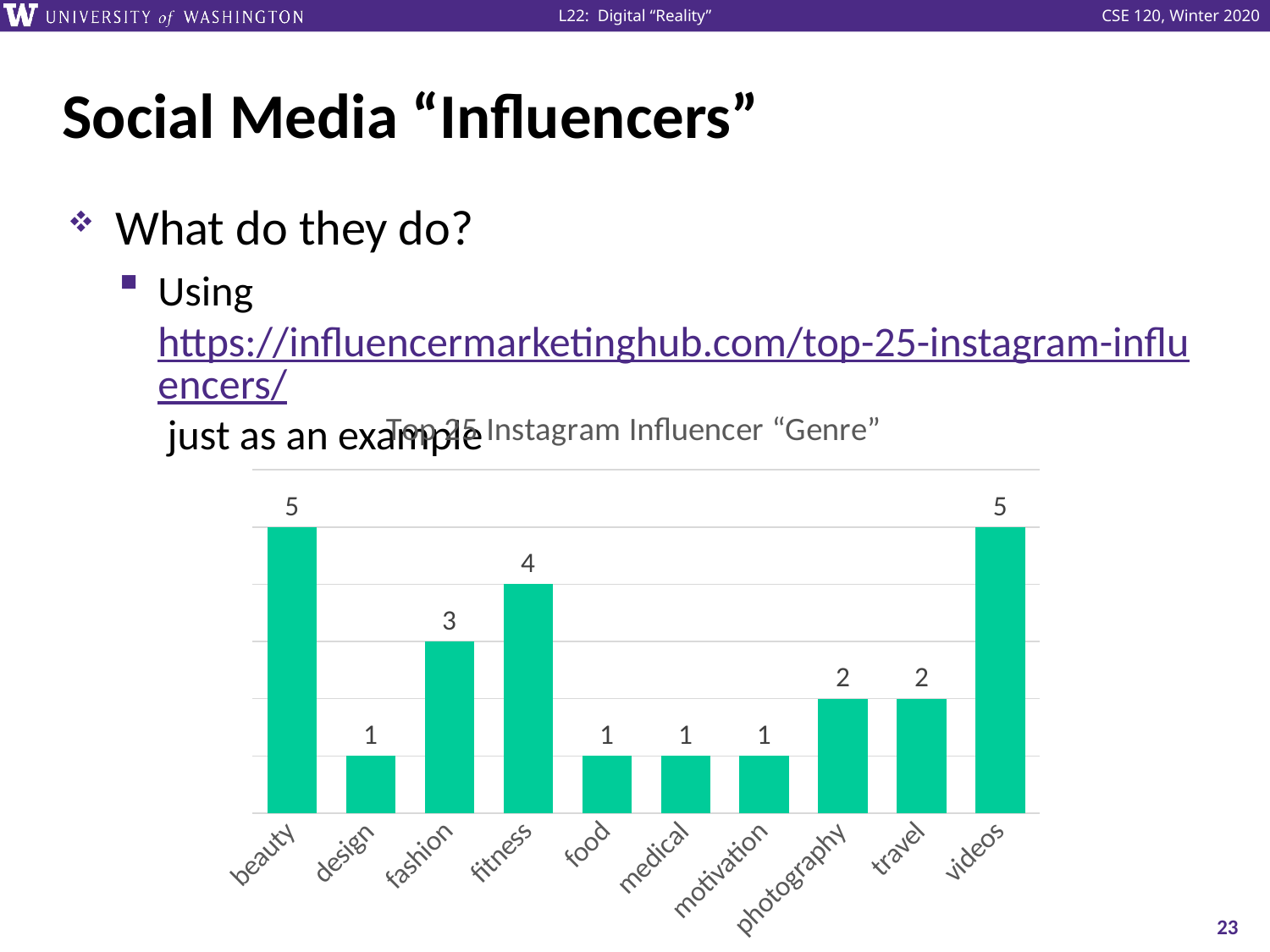
What is the highest value shown in the chart? 5 What is the difference between the values for fitness and travel? 2 How many categories are shown on the x axis of the chart? 10 What is the value for medical in the chart? 1 What is the value for photography in the chart? 2 What is the value for fitness in the chart? 4 Which has a larger value, fitness or photography? fitness What is the difference between the values for beauty and fashion? 2 What is the title of the chart? Top 25 Instagram Influencer "Genre" What is the value for fashion in the chart? 3 What kind of chart is shown on the slide? bar chart Which two categories share the highest value in the chart? beauty and videos